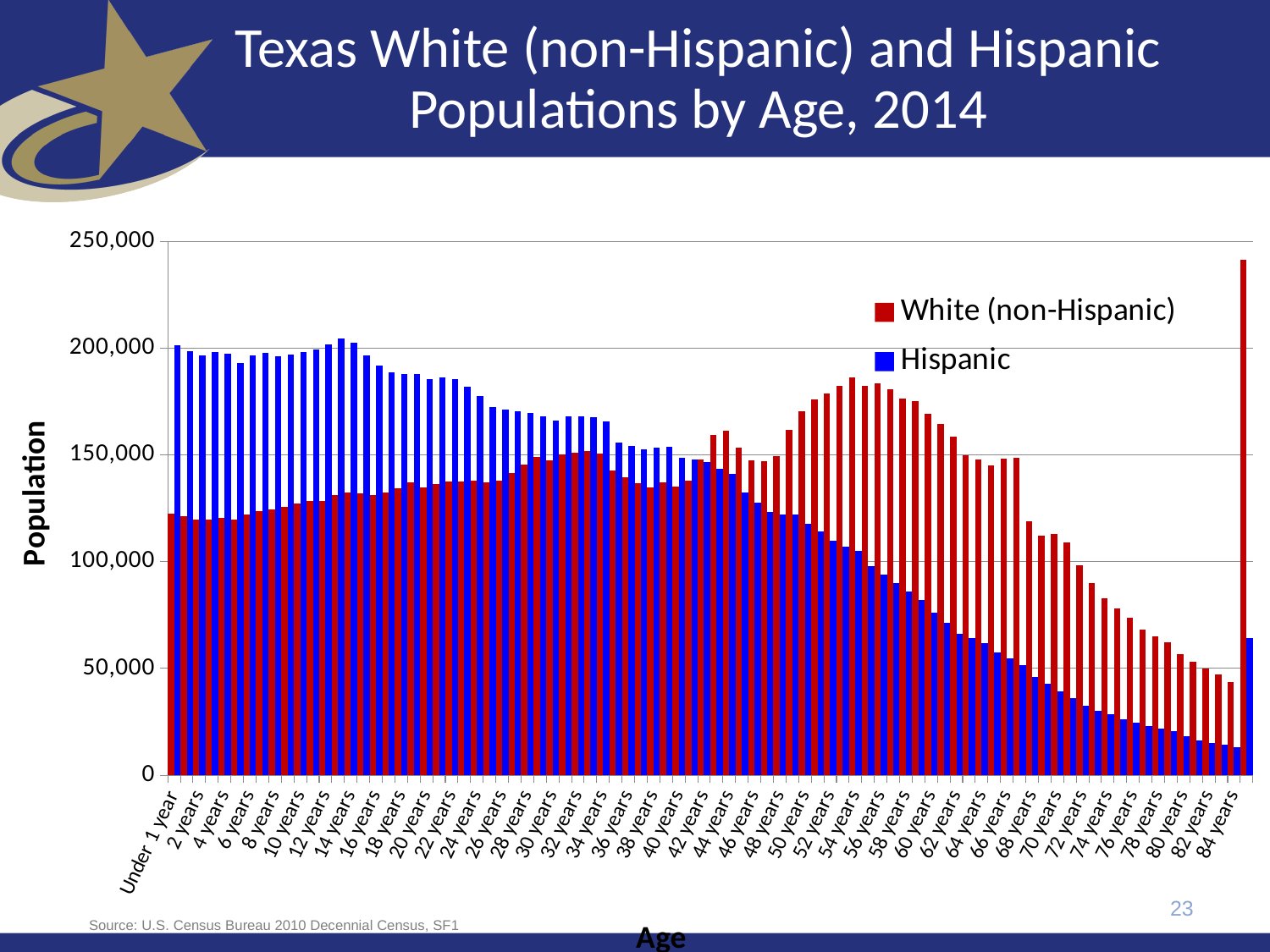
At 54 years, which series has the larger value, White (non-Hispanic) or Hispanic? White (non-Hispanic) Is the Hispanic value for 84 years greater or less than 50,000? less At Under 1 year, which series has the larger value, White (non-Hispanic) or Hispanic? Hispanic Is the Hispanic value for 60 years greater or less than 100,000? less How many series does the legend list? 2 Do the Hispanic values generally rise or fall as age increases from Under 1 year to 84 years? fall Which colour represents the Hispanic series in the legend? blue Is the White (non-Hispanic) value for Under 1 year greater or less than 100,000? greater What is the label on the vertical axis? Population What kind of chart is shown on the slide? bar chart